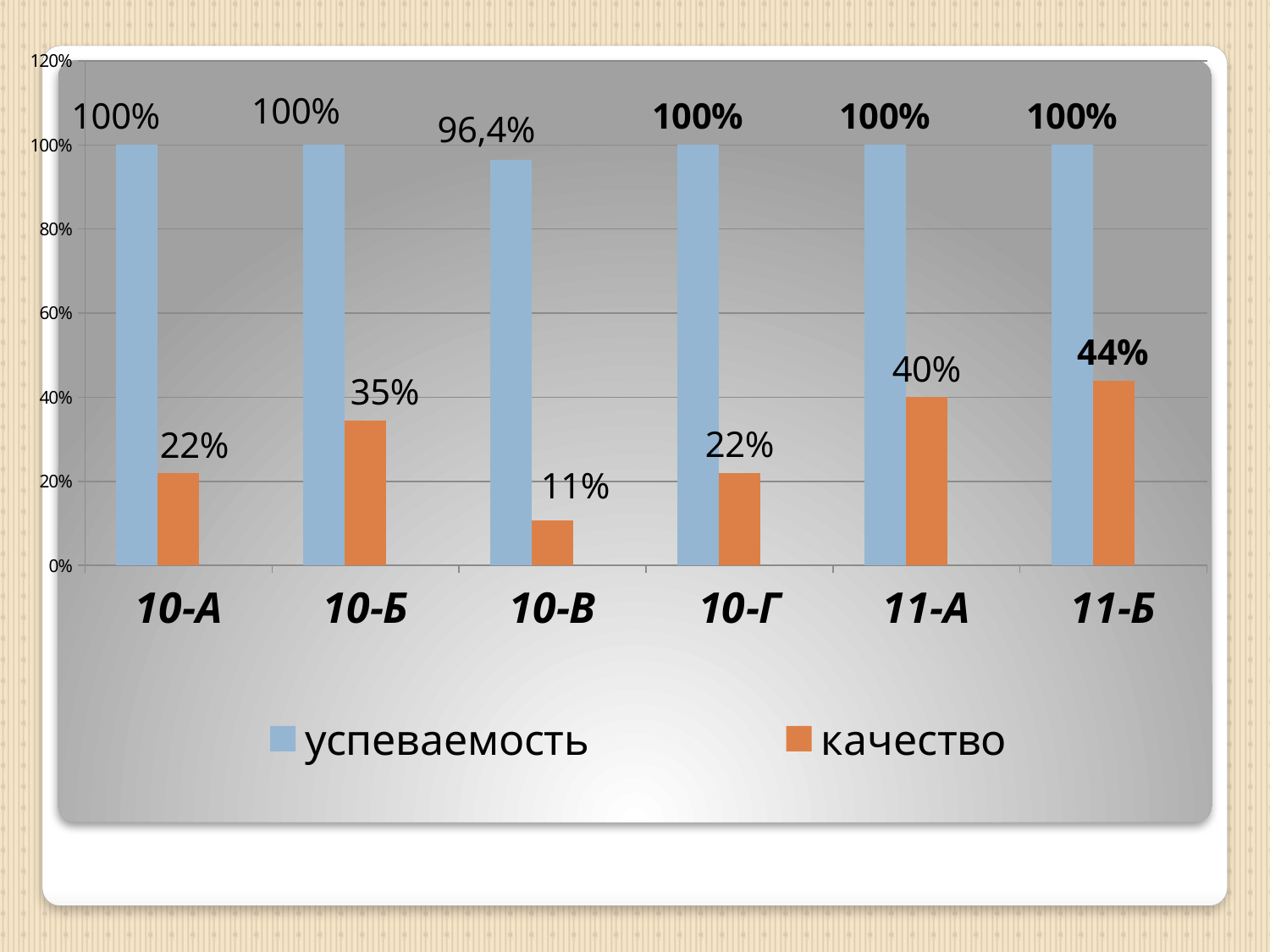
What is the качество value for 11-Б? 44% Which colour represents the качество series? orange Which category has the highest качество value? 11-Б What is the качество value for 10-Б? 35% Which category has the lowest успеваемость value? 10-В What kind of chart is shown on the slide? bar chart Which category has the lowest качество value? 10-В Which is larger, the качество value for 10-Б or for 11-А? 11-А How many categories are shown on the x axis? 6 How many series does the legend list? 2 What is the difference between the качество values for 11-А and 10-В? 29% What is the успеваемость value for 10-В? 96,4%